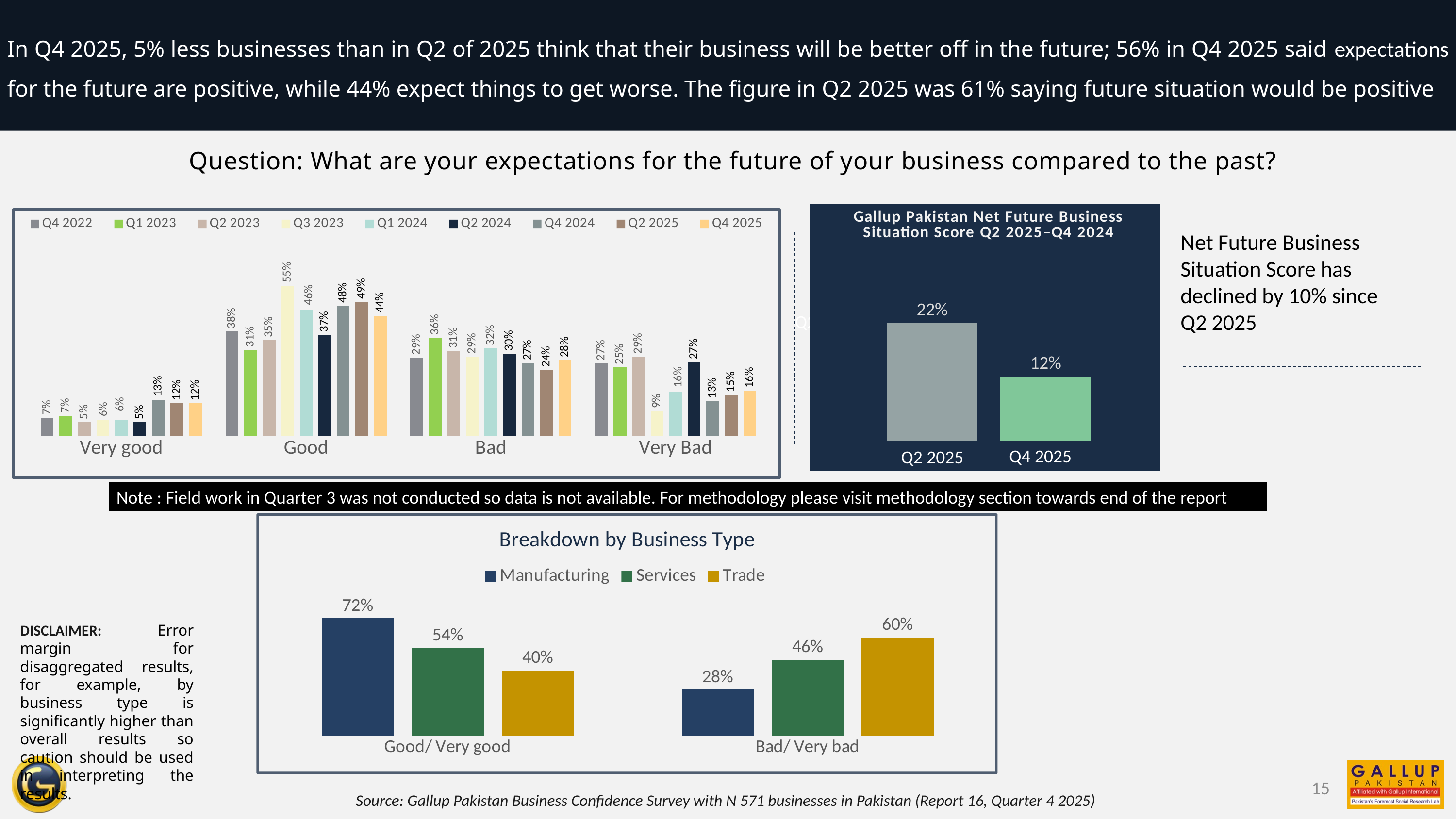
In the 'Breakdown by Business Type' chart, what is the difference between Services and Manufacturing in the Bad/ Very bad category? 18% In the 'Breakdown by Business Type' chart, what is the value for Trade in the Bad/ Very bad category? 60% In the top-left chart, what is the value for Q4 2025 in the Very Bad category? 16% In the 'Gallup Pakistan Net Future Business Situation Score' chart, what is the difference between Q2 2025 and Q4 2025? 10% How many series does the legend of the top-left chart list? 9 In the 'Breakdown by Business Type' chart, which business type has the lowest value in the Good/ Very good category? Trade In the 'Gallup Pakistan Net Future Business Situation Score' chart, what is the value for Q4 2025? 12% What kind of chart is the 'Gallup Pakistan Net Future Business Situation Score' chart? Bar chart In the top-left chart, which series has the highest value in the Good category? Q3 2023 How many series does the legend of the 'Breakdown by Business Type' chart list? 3 In the top-left chart, what is the value for Q3 2023 in the Good category? 55% In the 'Breakdown by Business Type' chart, what is the value for Manufacturing in the Good/ Very good category? 72%